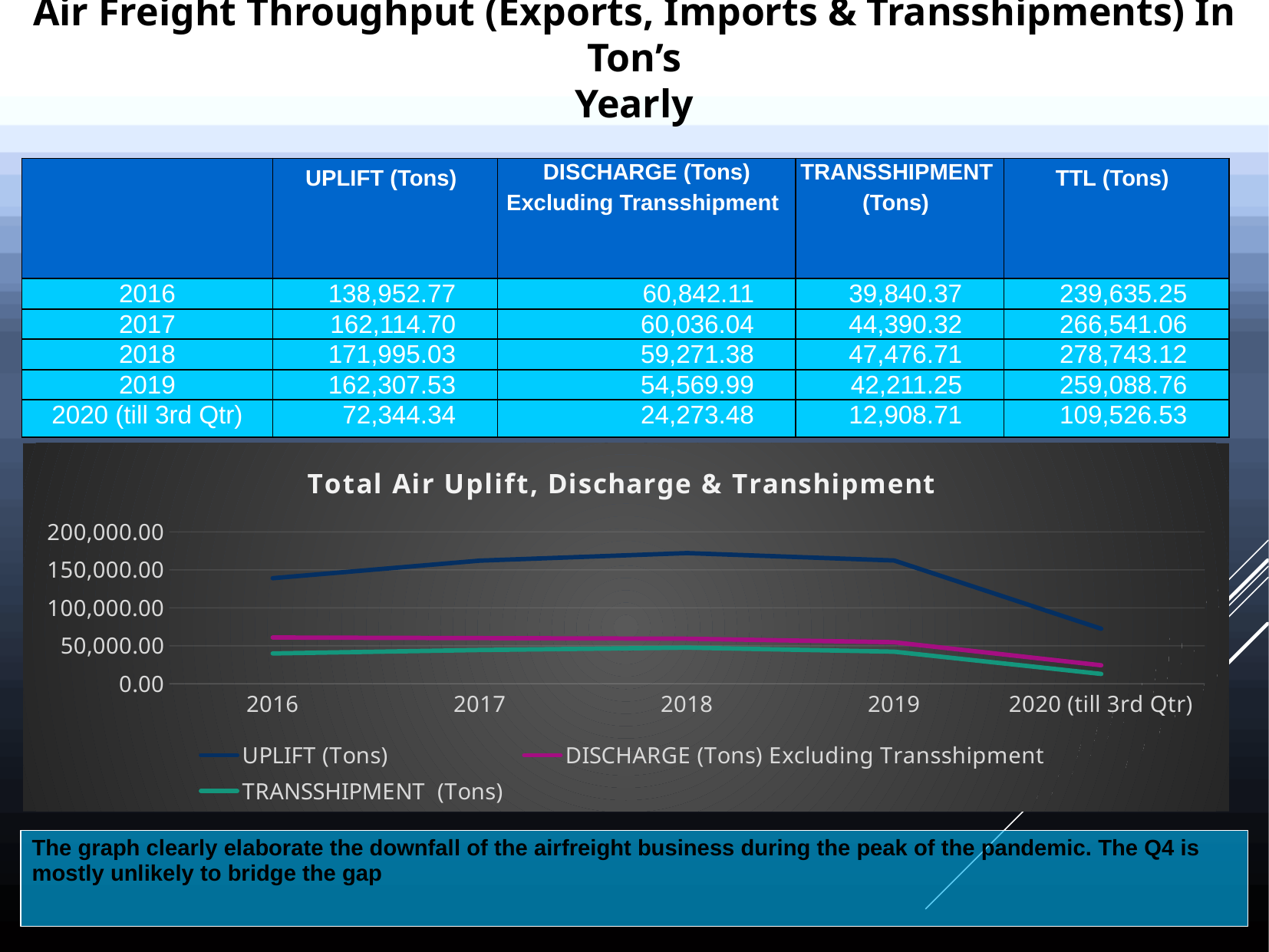
In which year is the UPLIFT (Tons) value highest? 2018 In which year is the UPLIFT (Tons) value lowest? 2020 (till 3rd Qtr) What is the difference between the UPLIFT (Tons) values for 2018 and 2019? 9,687.50 What is the TRANSSHIPMENT (Tons) value for 2018? 47,476.71 How many years (categories) are plotted along the x axis of the chart? 5 Is the UPLIFT (Tons) value for 2020 (till 3rd Qtr) greater or less than 100,000.00? less How many series does the chart legend list? 3 In 2019, which is larger: DISCHARGE (Tons) Excluding Transshipment or TRANSSHIPMENT (Tons)? DISCHARGE (Tons) Excluding Transshipment What is the UPLIFT (Tons) value for 2016? 138,952.77 What kind of chart is shown on the slide? line chart Does the UPLIFT (Tons) line rise or fall from 2019 to 2020 (till 3rd Qtr)? fall What is the title of the chart? Total Air Uplift, Discharge & Transhipment